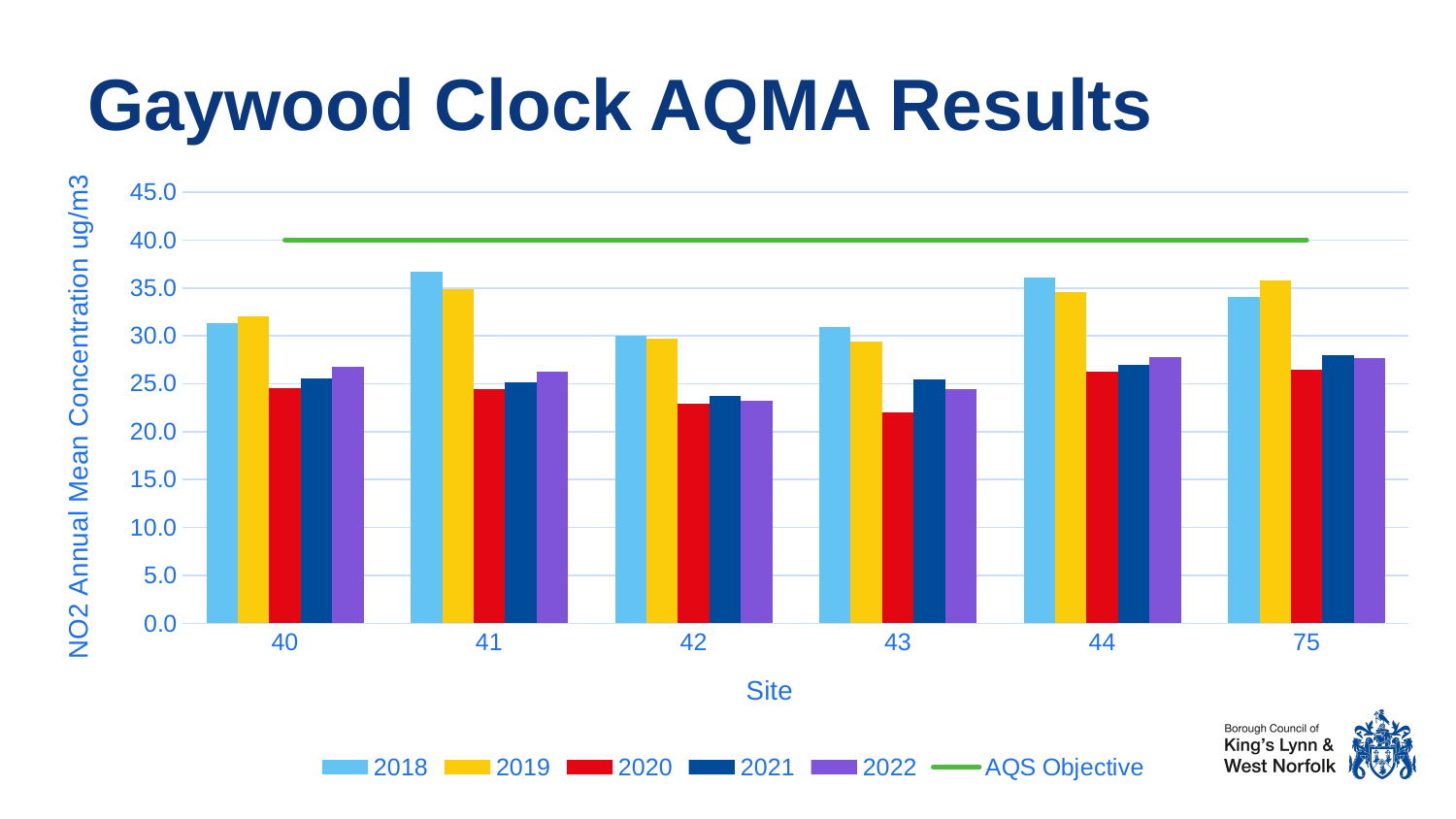
What kind of chart is shown on the slide? bar chart Is the 2019 value for site 44 greater or less than 30.0? greater Do any of the bars exceed the AQS Objective line? No How many entries does the legend list? 6 What value does the AQS Objective line sit at? 40.0 How many sites are shown on the x axis? 6 At site 43, which year has the highest value? 2018 At site 41, which is larger, the 2018 value or the 2020 value? 2018 Is the 2020 value for site 43 greater or less than 25.0? less Is the 2018 value for site 41 greater or less than 35.0? greater At site 43, which year has the lowest value? 2020 What colour is the AQS Objective line in the legend? green